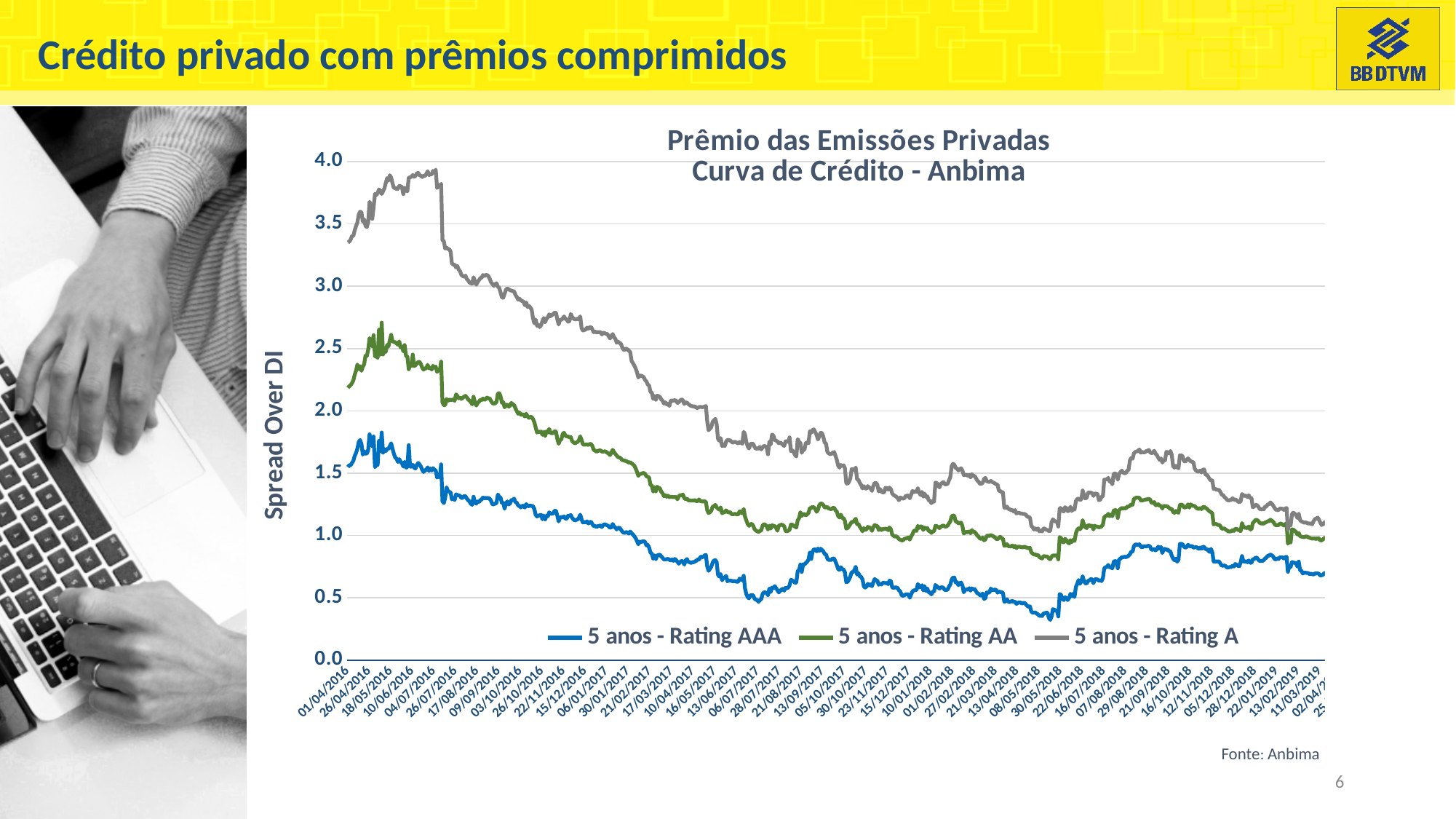
What kind of chart is shown on the slide? line chart What are the three series listed in the legend? 5 anos - Rating AAA, 5 anos - Rating AA, 5 anos - Rating A Is the value for 5 anos - Rating AAA at 01/04/2016 greater or less than 2.0? less At 01/04/2016, which is larger: the value for 5 anos - Rating AA or for 5 anos - Rating AAA? 5 anos - Rating AA Is the value for 5 anos - Rating AA at 02/04/2019 greater or less than 1.5? less Overall, do the values for the 5 anos - Rating AAA series rise or fall across the period shown? fall What is the title of the chart? Prêmio das Emissões Privadas Curva de Crédito - Anbima How many series does the legend list? 3 Overall, do the values for the 5 anos - Rating A series rise or fall from 01/04/2016 to the end of the period? fall Is the value for 5 anos - Rating A at 01/04/2016 greater or less than 3.0? greater Which series has the highest values throughout the period shown? 5 anos - Rating A